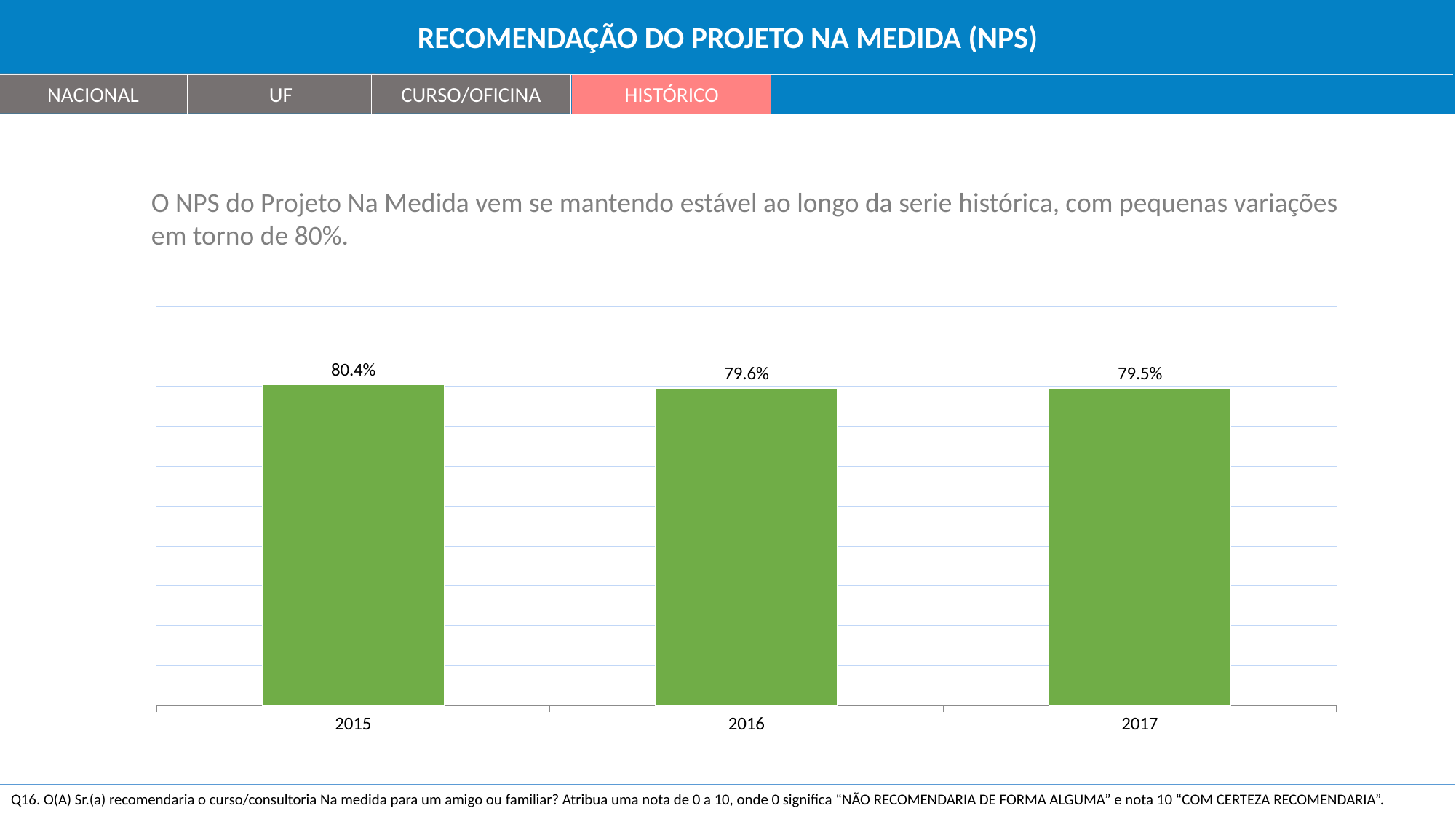
What kind of chart is shown on the slide? Bar chart How many years are shown in the chart? 3 What is the difference between the NPS values for 2015 and 2017? 0.9 percentage points What is the NPS value shown for 2017? 79.5% Do the NPS values rise or fall from 2015 to 2017? Fall What is the difference between the NPS values for 2015 and 2016? 0.8 percentage points Which year has a larger NPS value, 2016 or 2017? 2016 Which year has the lowest NPS value in the chart? 2017 Which year has the highest NPS value in the chart? 2015 What is the NPS value shown for 2015? 80.4% What is the NPS value shown for 2016? 79.6% Which year has a larger NPS value, 2015 or 2017? 2015